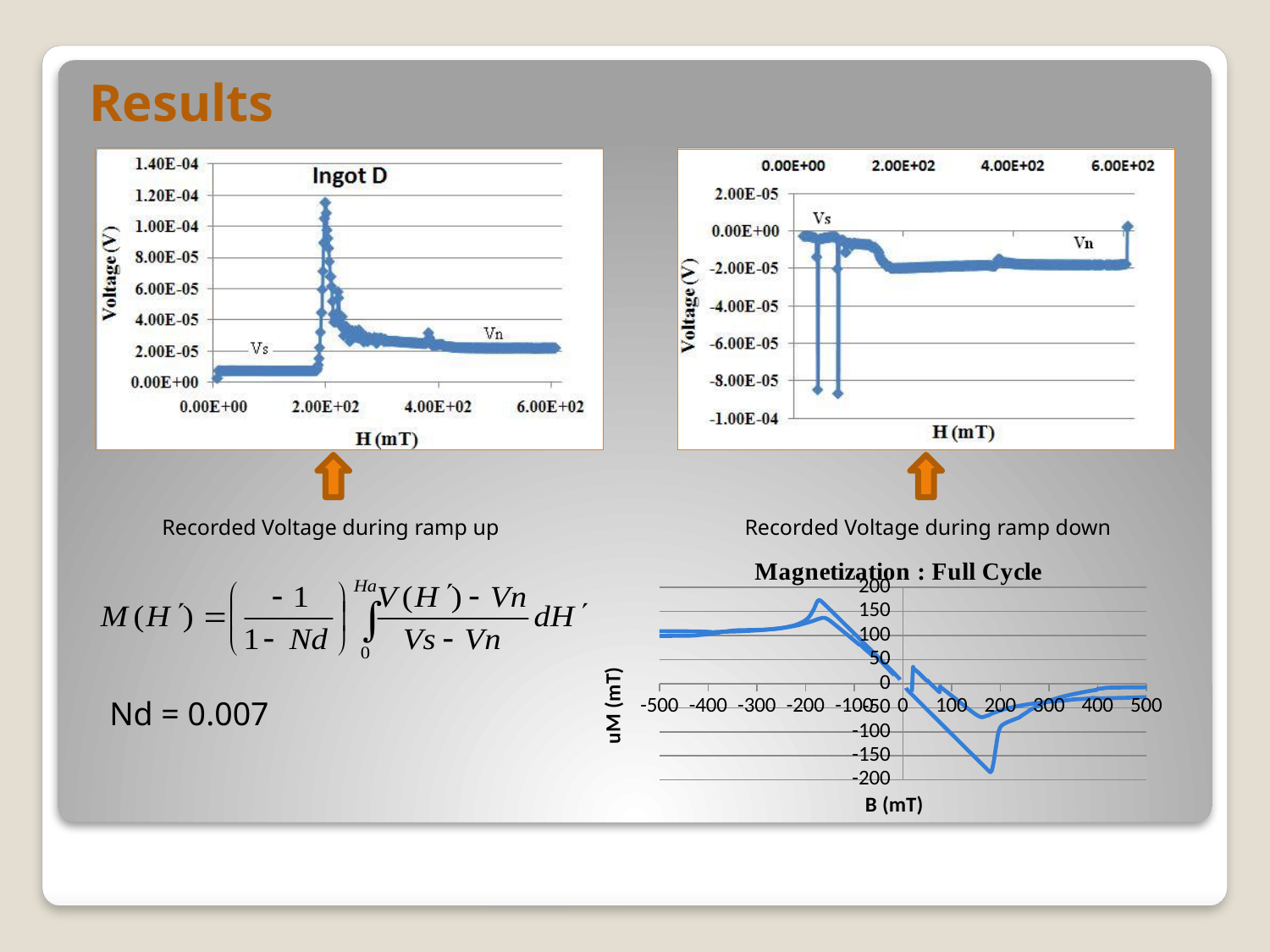
In the Magnetization : Full Cycle chart, is the maximum uM value greater or less than 150? greater What is the title of the top-left chart? Ingot D What is the y-axis label of the Magnetization : Full Cycle chart? uM (mT) In the Magnetization : Full Cycle chart, is the minimum uM value greater or less than -150? less In the ramp down chart (top right), is the voltage at H = 4.00E+02 greater or less than 0.00E+00? less In the Magnetization : Full Cycle chart, does uM rise or fall as B goes from -100 to 100? fall In the Magnetization : Full Cycle chart, is uM larger at B = -200 or at B = 200? -200 What kind of chart is the Ingot D chart? line chart